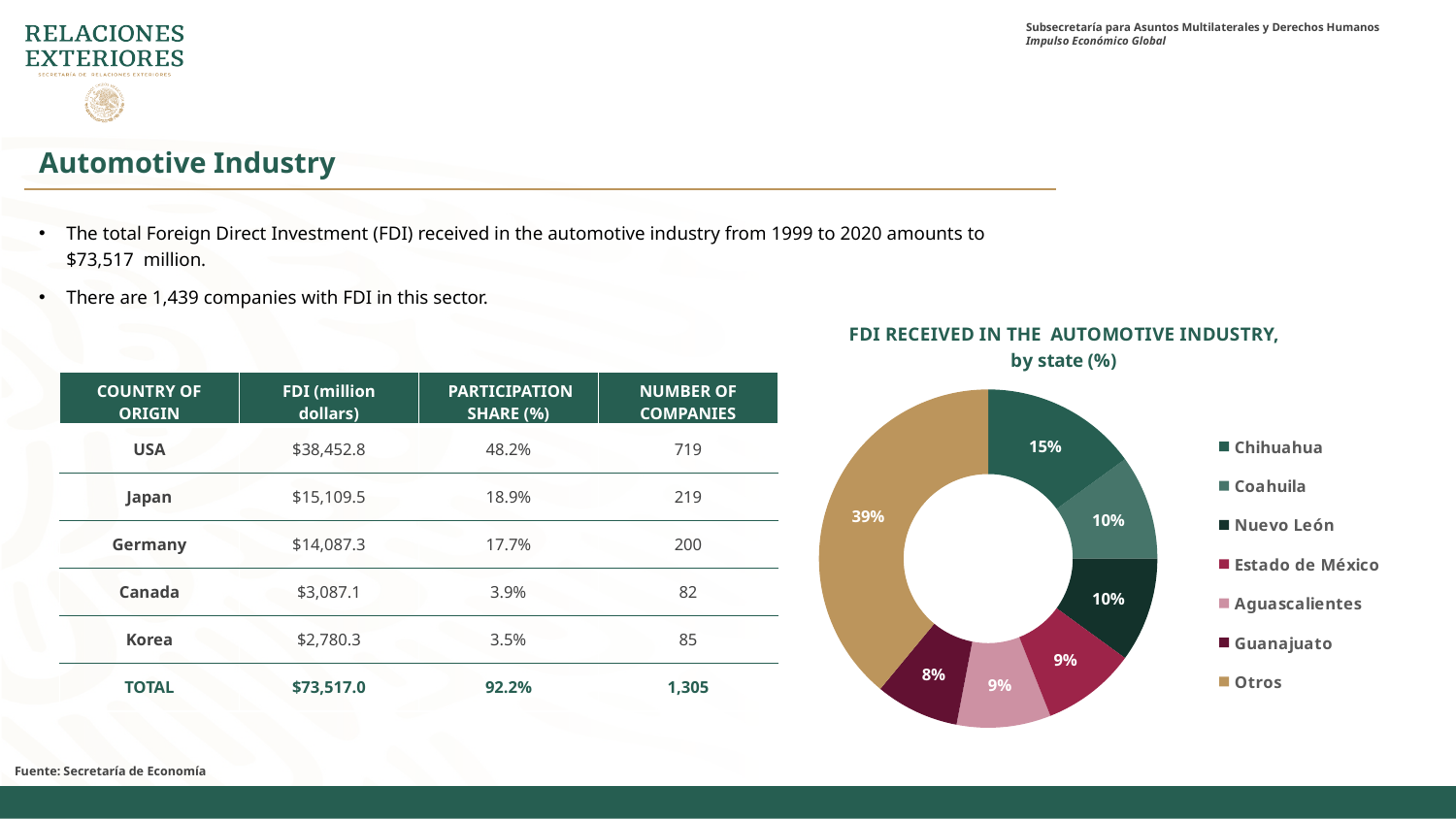
What share of FDI received in the automotive industry does Coahuila account for? 10% What type of chart is shown on the slide? Doughnut (pie) chart How many states/categories are shown in the chart legend? 7 What share of FDI received in the automotive industry does Guanajuato account for? 8% What share of FDI received in the automotive industry does Chihuahua account for? 15% Which category has the largest share in the chart? Otros Which named state has the smallest share in the chart? Guanajuato What is the difference in percentage points between Chihuahua's share and Guanajuato's share? 7 percentage points What is the title of the chart? FDI RECEIVED IN THE AUTOMOTIVE INDUSTRY, by state (%) What colour represents Otros in the chart? Tan/gold Which has a larger share of FDI, Chihuahua or Coahuila? Chihuahua What share of FDI received in the automotive industry does Otros account for? 39%